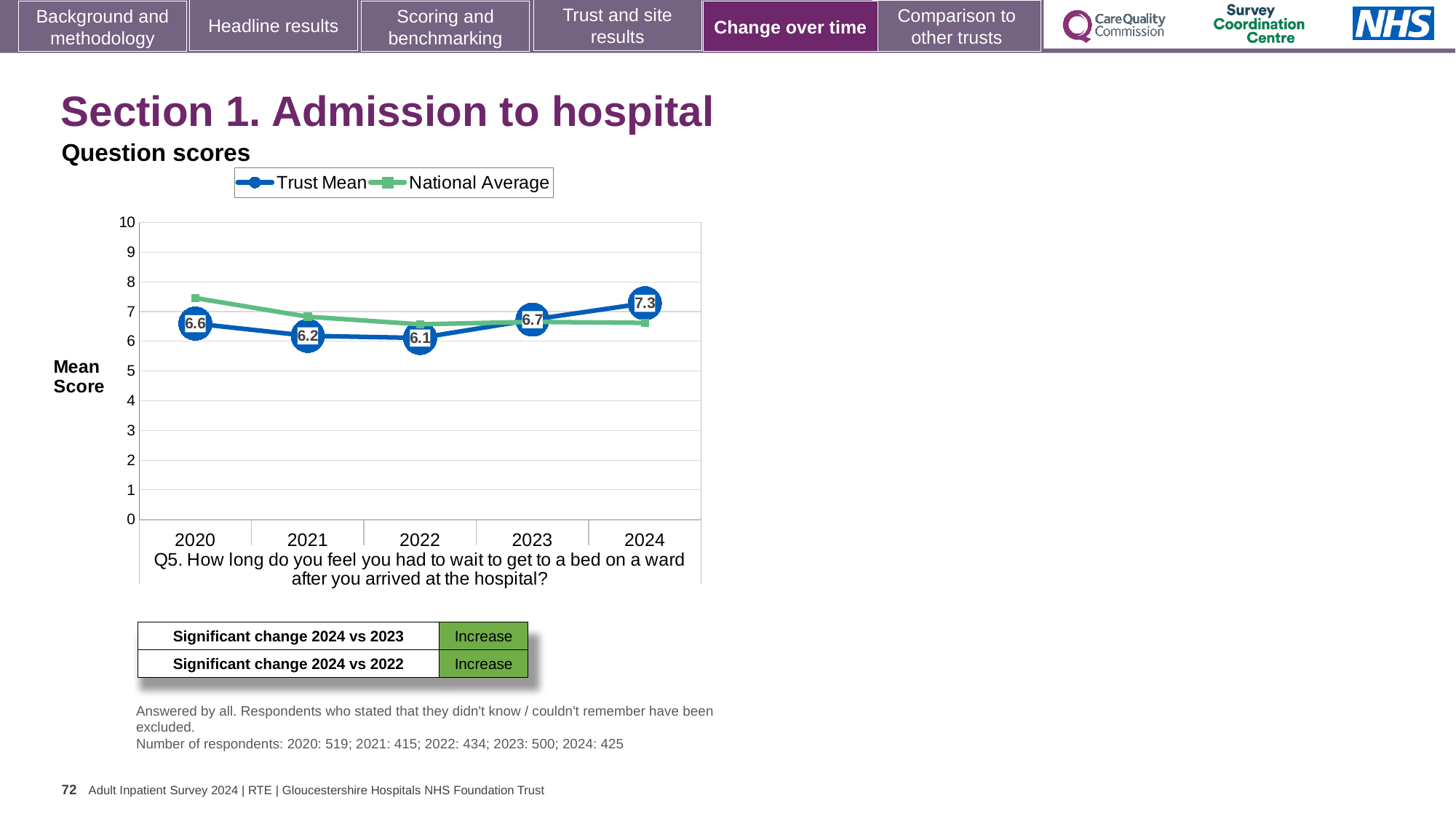
What is the difference between the Trust Mean scores for 2024 and 2023? 0.6 How many series does the chart legend list? 2 In 2024, which is higher: the Trust Mean or the National Average? Trust Mean In which year is the Trust Mean score lowest? 2022 What is the Trust Mean score for 2024? 7.3 What is the Trust Mean score for 2021? 6.2 In which year is the Trust Mean score highest? 2024 What is the Trust Mean score for 2020? 6.6 In 2020, which is higher: the Trust Mean or the National Average? National Average How many years are shown on the x axis of the chart? 5 Is the National Average value for 2020 greater or less than 7? greater What is the difference between the Trust Mean scores for 2020 and 2022? 0.5